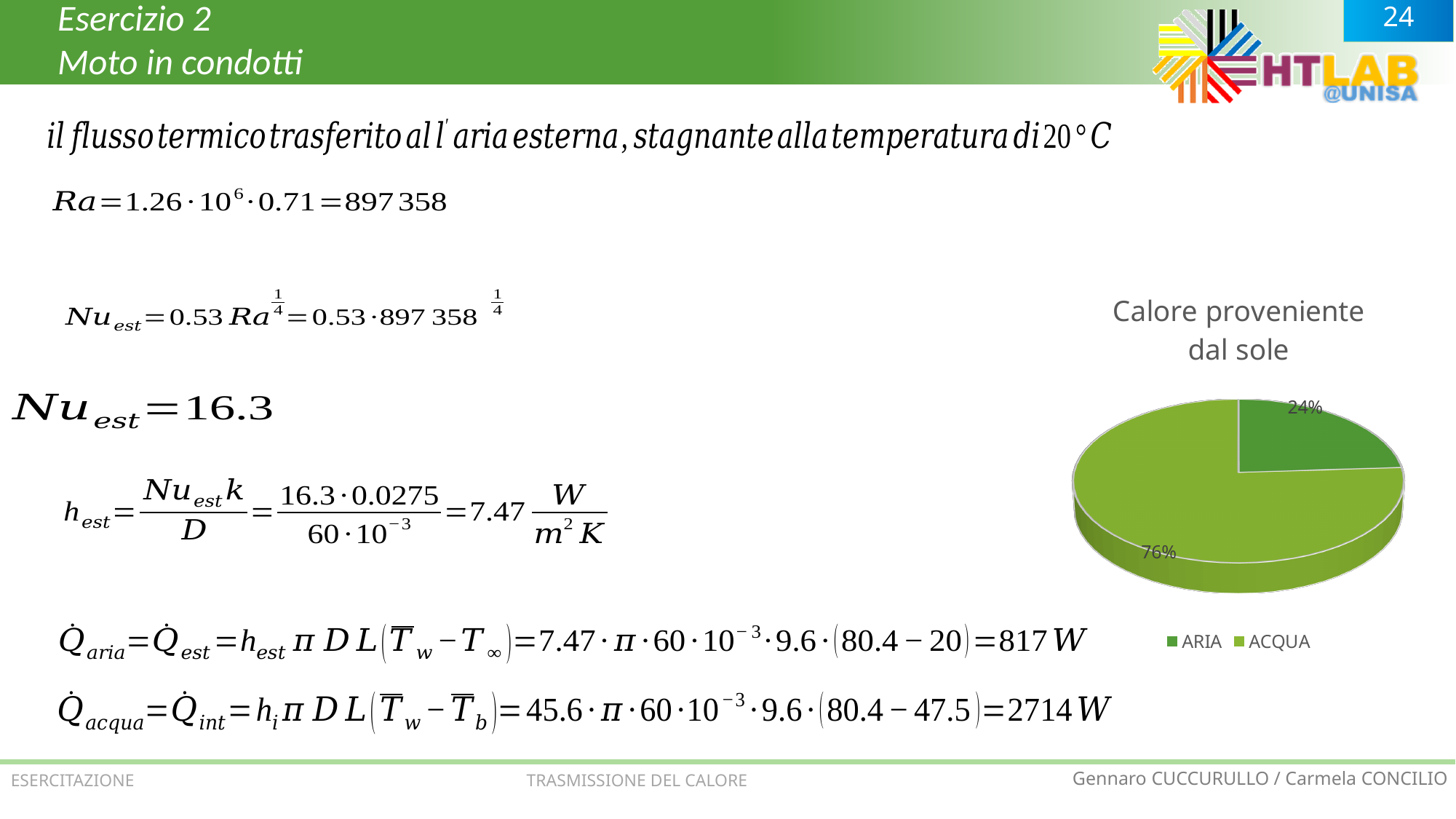
What is the title of the pie chart? Calore proveniente dal sole Which is larger in the pie chart, ARIA or ACQUA? ACQUA What share of the pie does ACQUA represent? 76% How many slices does the pie chart have? 2 Is the share for ACQUA greater or less than 50%? greater Which slice of the pie chart is the largest? ACQUA What share of the pie does ARIA represent? 24% Which legend entry is shown in the lighter green colour? ACQUA How many entries does the legend of the pie chart list? 2 Which slice of the pie chart is the smallest? ARIA What is the difference in percentage points between the ACQUA and ARIA slices? 52 What kind of chart is shown on the slide? pie chart